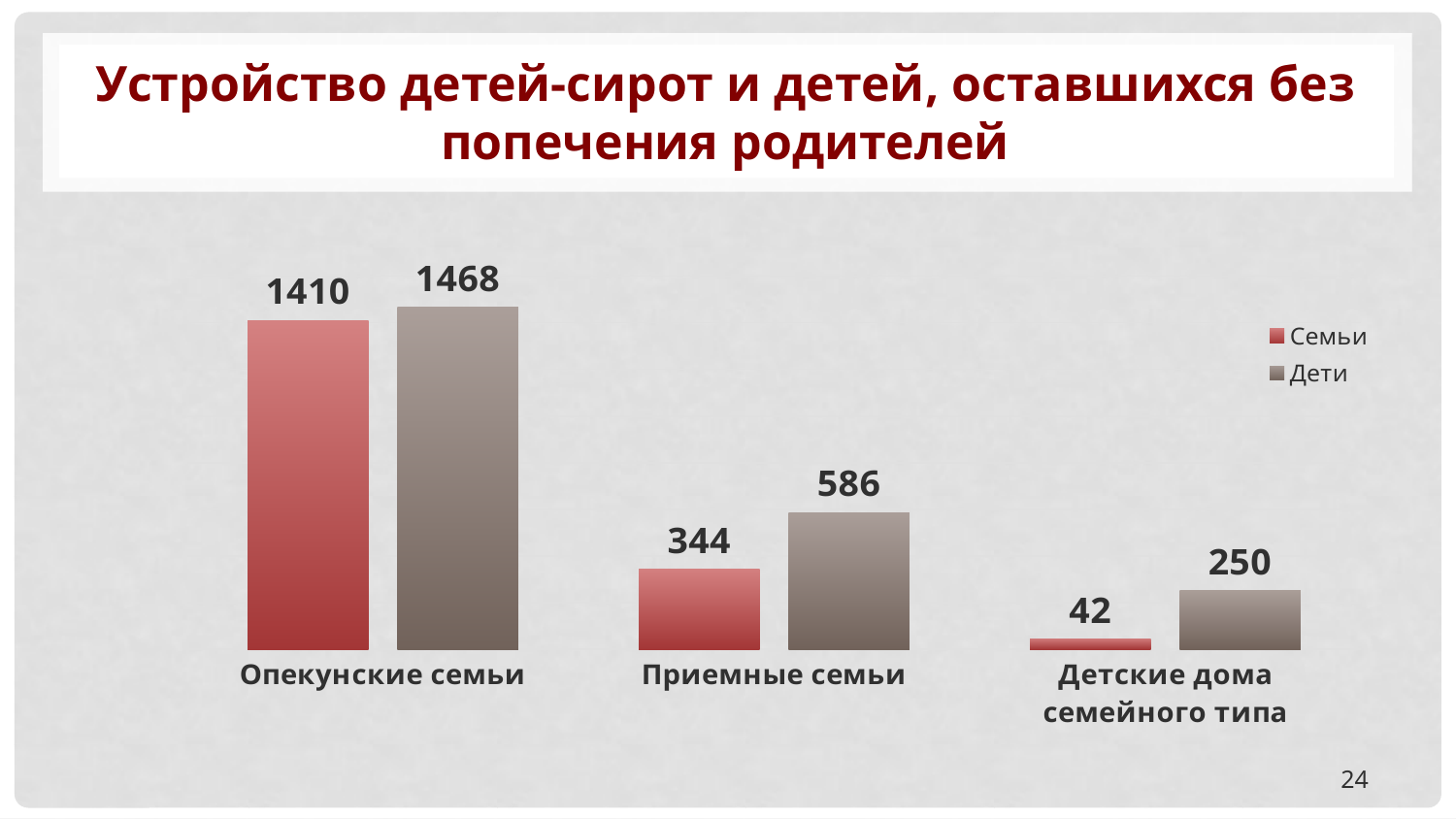
Do the values for Семьи rise or fall from left to right across the categories? Fall What is the difference between Дети and Семьи in the Опекунские семьи category? 58 What is the value for Семьи in the Детские дома семейного типа category? 42 Which category has the lowest value for Семьи? Детские дома семейного типа How many categories are shown on the x axis? 3 What kind of chart is shown on the slide? Bar chart Which category has the highest value for Дети? Опекунские семьи What is the difference between Дети and Семьи in the Приемные семьи category? 242 How many series does the legend list? 2 What is the value for Семьи in the Опекунские семьи category? 1410 Which is larger: Дети for Детские дома семейного типа or Семьи for Приемные семьи? Семьи for Приемные семьи What is the value for Дети in the Приемные семьи category? 586